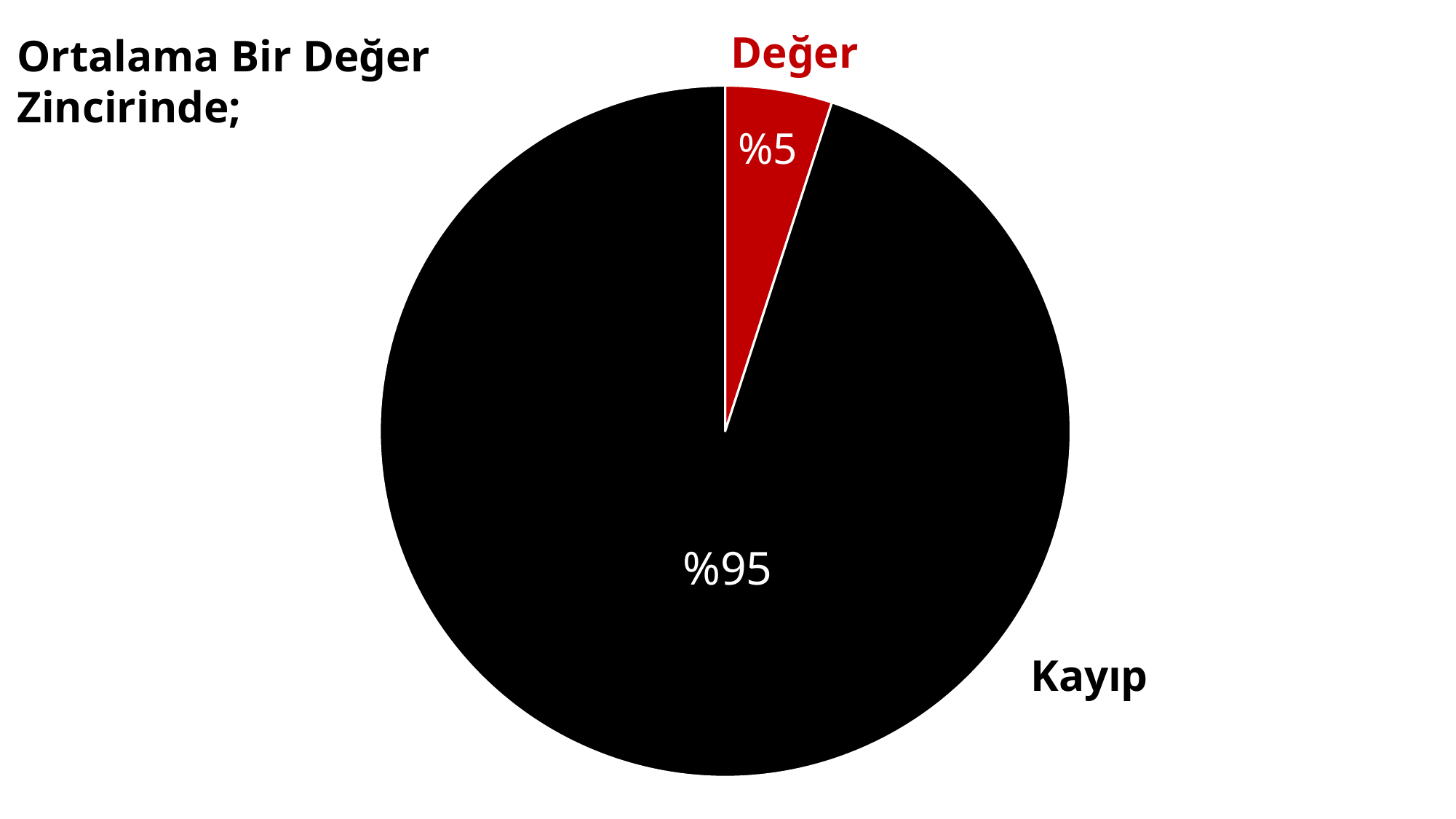
Which slice is the smallest? Değer What share of the pie does the Kayıp slice represent? %95 How many slices does the pie chart have? 2 What kind of chart is shown on the slide? pie chart What is the value shown for the Değer slice? %5 What is the value shown for the Kayıp slice? %95 Which slice is the largest? Kayıp What colour is the Değer slice? red What is the text in the top-left corner of the slide? Ortalama Bir Değer Zincirinde; What is the difference between the Kayıp and Değer values? %90 Which is larger, Değer or Kayıp? Kayıp